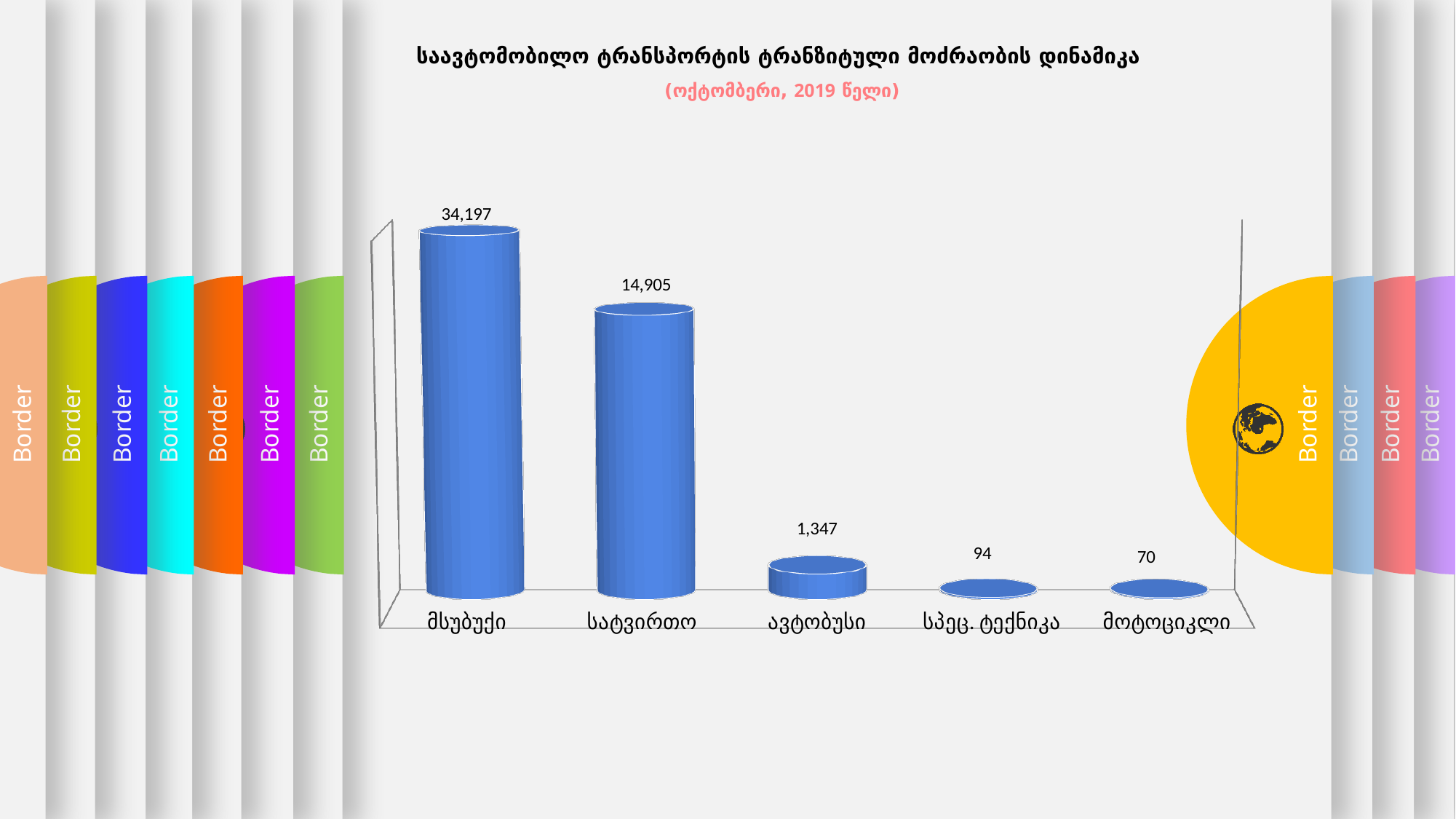
What is the difference between the values for მსუბუქი and სატვირთო? 19,292 What is the value for სპეც. ტექნიკა? 94 What is the value for მოტოციკლი? 70 Which category has the lowest value? მოტოციკლი Which category has the highest value? მსუბუქი What is the value for მსუბუქი? 34,197 Which is larger, the value for სატვირთო or the value for ავტობუსი? სატვირთო What is the difference between the values for სპეც. ტექნიკა and მოტოციკლი? 24 What is the value for ავტობუსი? 1,347 How many categories are shown in the chart? 5 What is the value for სატვირთო? 14,905 What kind of chart is shown on the slide? Bar chart